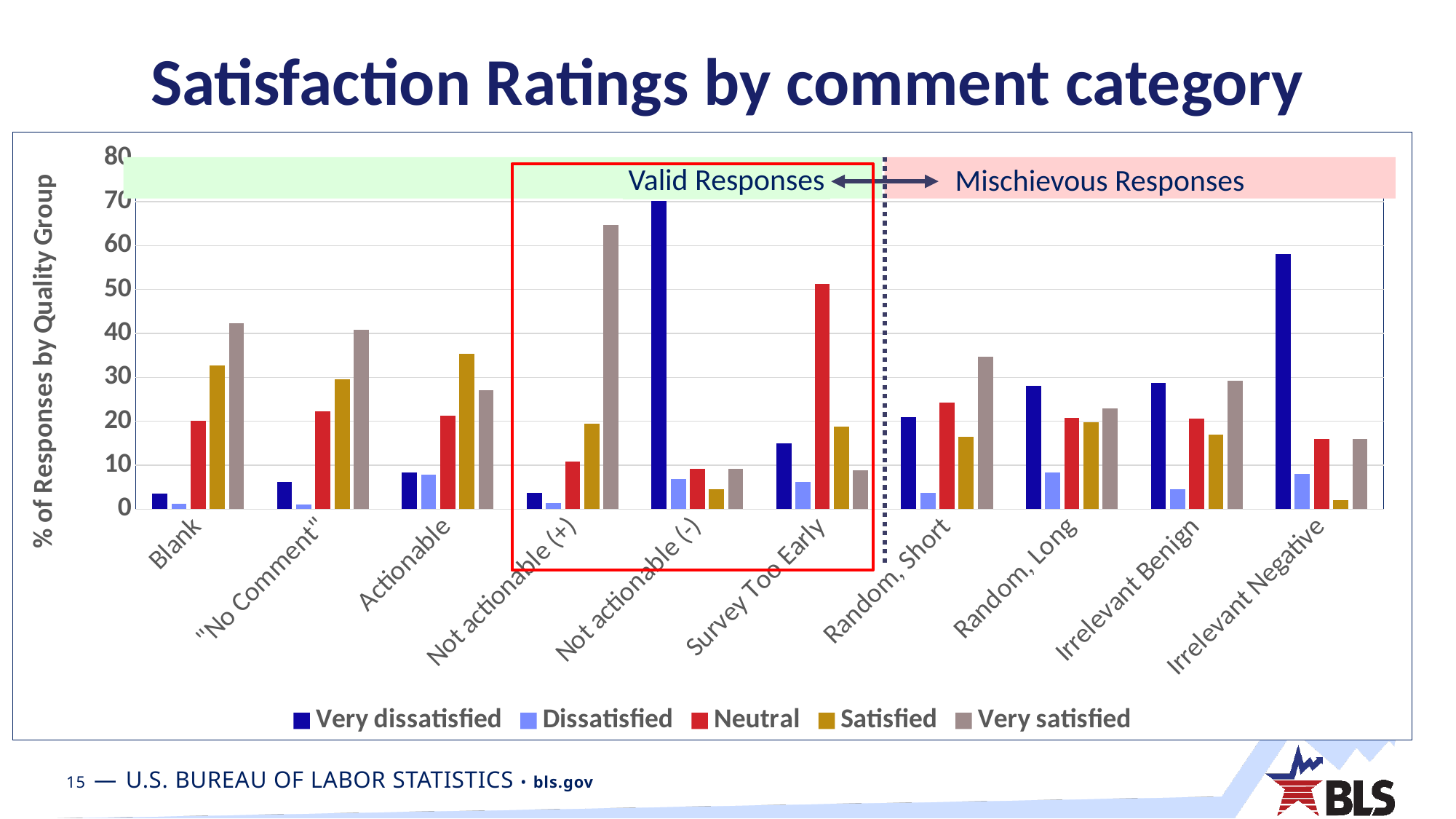
Is the Satisfied value for Actionable greater or less than 30? greater How many series does the legend list? 5 Which comment category has the highest Very dissatisfied bar? Not actionable (-) Is the Neutral value for Survey Too Early greater or less than 40? greater For the Irrelevant Negative category, which series has the lowest bar? Satisfied What is the title of the y axis? % of Responses by Quality Group Which comment category has the highest Very satisfied bar? Not actionable (+) Is the Very dissatisfied value for Not actionable (-) greater or less than 60? greater For the Blank category, which is larger: the Satisfied bar or the Very satisfied bar? Very satisfied What kind of chart is shown on the slide? bar chart How many comment categories are shown on the x axis? 10